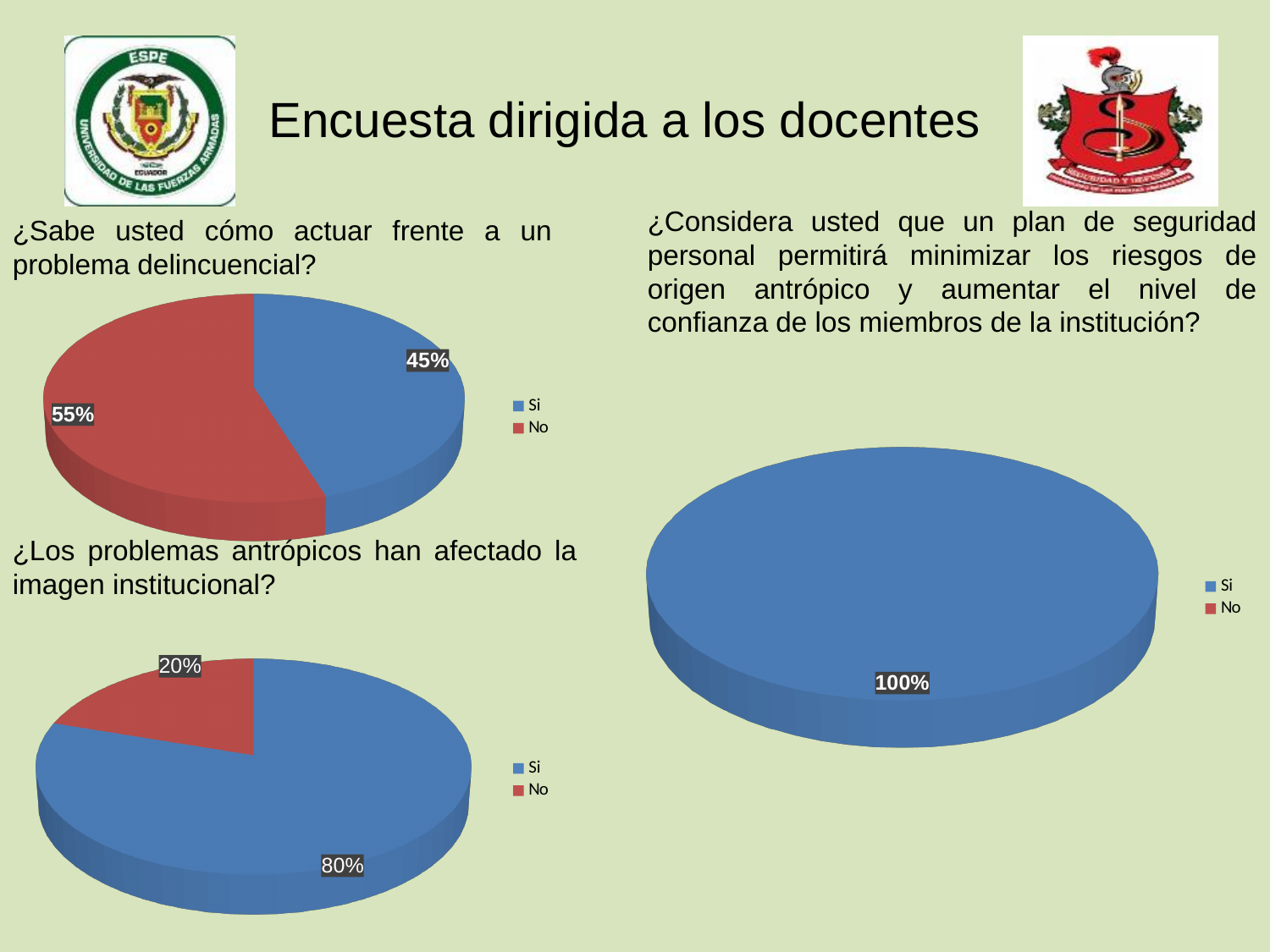
In the top-left pie chart (¿Sabe usted cómo actuar frente a un problema delincuencial?), what is the difference between the No share and the Si share? 10% How many entries does the legend of the pie chart on the right list? 2 What type of chart is used for the three charts on this slide? Pie chart In the bottom-left pie chart (¿Los problemas antrópicos han afectado la imagen institucional?), what share of respondents answered No? 20% In the bottom-left pie chart (¿Los problemas antrópicos han afectado la imagen institucional?), which answer has the smaller share? No In the top-left pie chart, which colour represents the No answer? Red In the pie chart on the right (¿Considera usted que un plan de seguridad personal permitirá minimizar los riesgos...?), what share of respondents answered Si? 100% In the bottom-left pie chart (¿Los problemas antrópicos han afectado la imagen institucional?), what share of respondents answered Si? 80% In the bottom-left pie chart (¿Los problemas antrópicos han afectado la imagen institucional?), what is the difference between the Si share and the No share? 60% In the top-left pie chart (¿Sabe usted cómo actuar frente a un problema delincuencial?), which answer has the larger share? No In the top-left pie chart (¿Sabe usted cómo actuar frente a un problema delincuencial?), what share of respondents answered Si? 45% In the top-left pie chart (¿Sabe usted cómo actuar frente a un problema delincuencial?), what share of respondents answered No? 55%